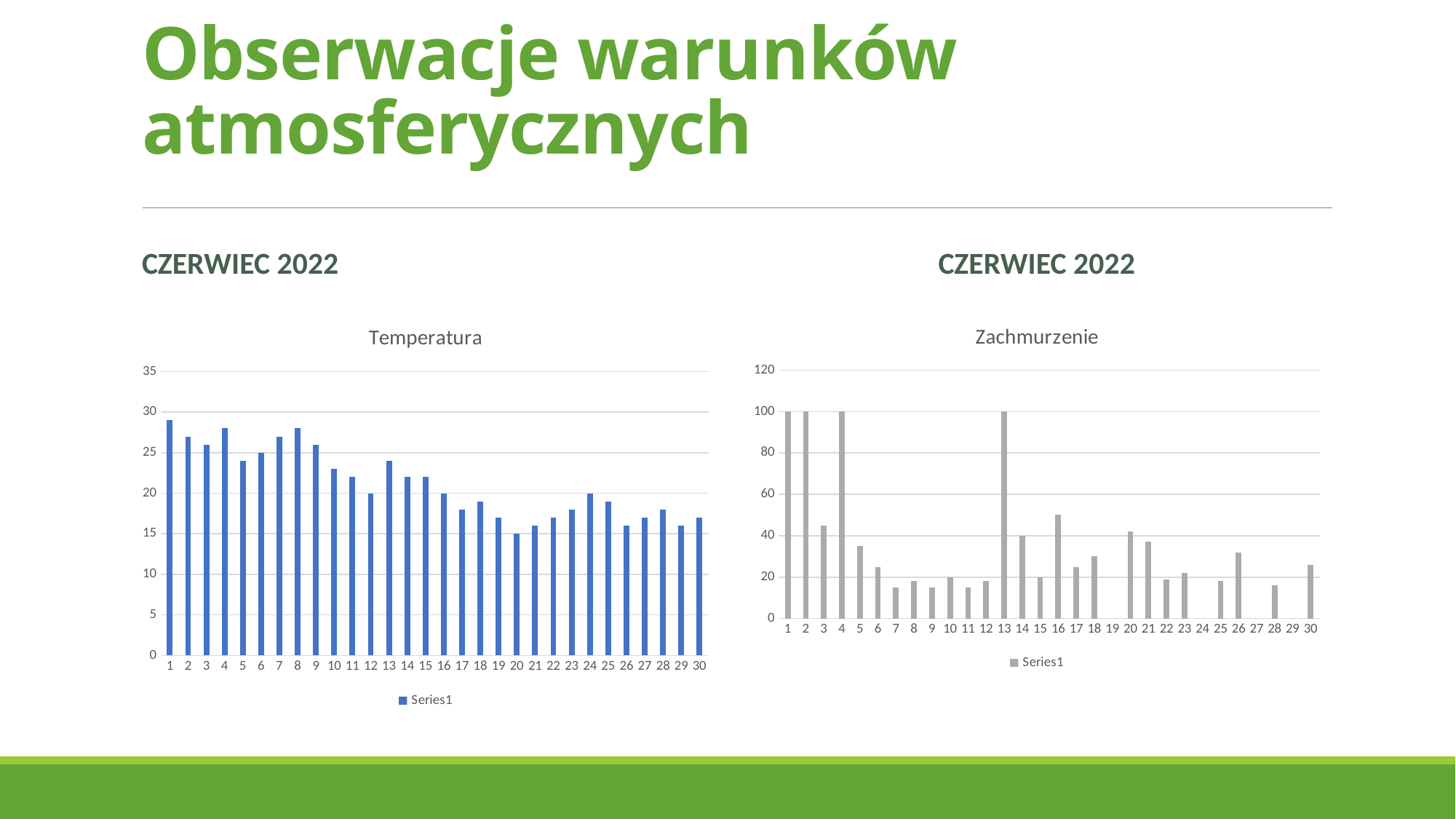
How many days (categories) are plotted on the Temperatura chart? 30 On the Temperatura chart, which is larger, the value for day 1 or the value for day 20? day 1 On the Zachmurzenie chart, is the value for day 16 greater or less than 40? greater On the Zachmurzenie chart, what is the value for day 13? 100 What is the title of the chart on the right side of the slide? Zachmurzenie What kind of chart is the Temperatura chart? bar chart On the Temperatura chart, what is the value for day 20? 15 On the Temperatura chart, is the value for day 1 greater or less than 25? greater On the Zachmurzenie chart, what is the value for day 1? 100 How many series does the legend of the Zachmurzenie chart list? 1 On the Temperatura chart, do the values generally rise or fall from day 1 to day 30? fall On the Zachmurzenie chart, is the value for day 7 greater or less than 20? less